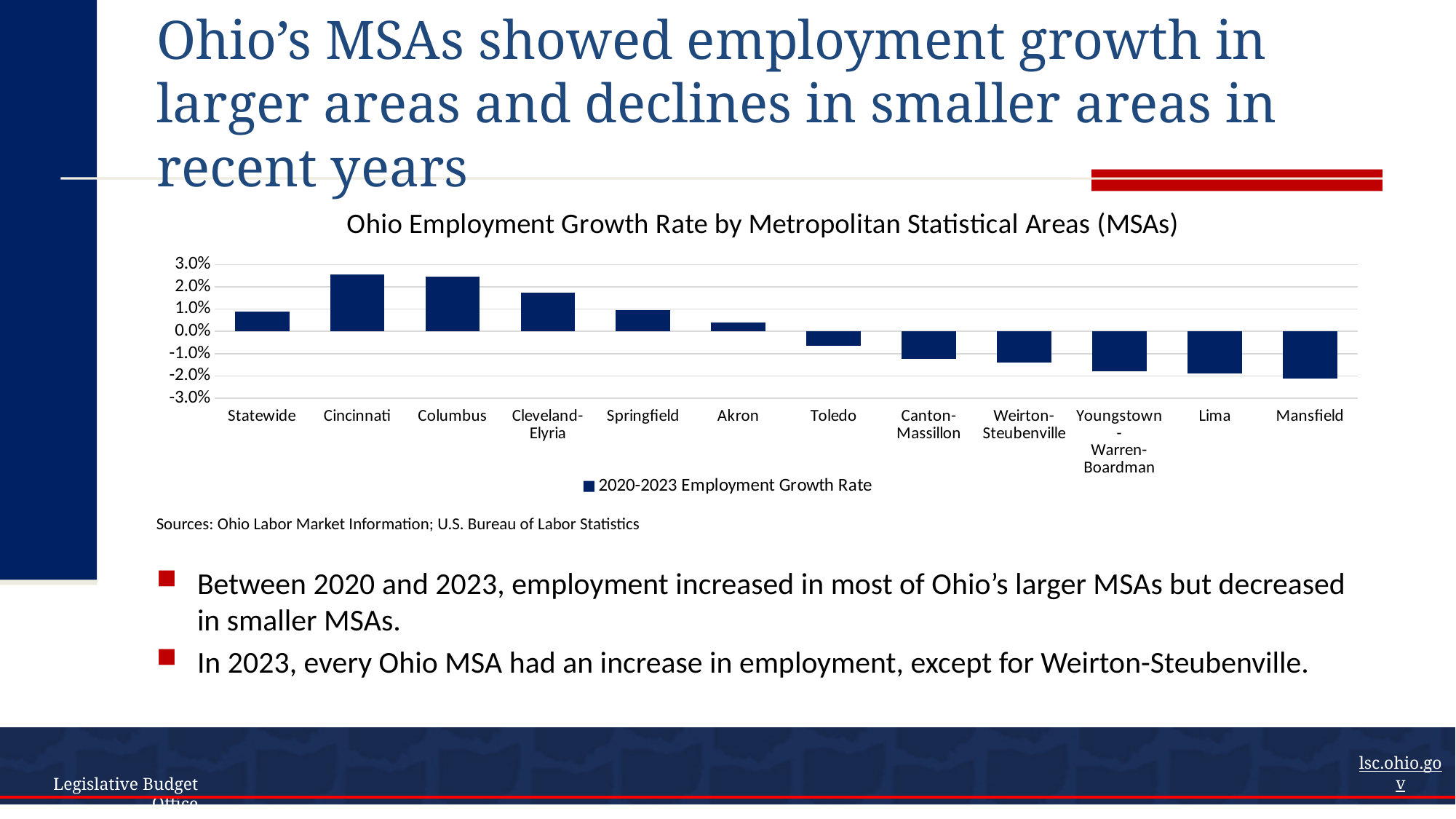
How many series does the chart's legend list? 1 Which category has the lowest employment growth rate in the chart? Mansfield Do the values generally rise or fall moving from left to right along the x axis? fall Which has the larger employment growth rate, Toledo or Mansfield? Toledo Is the value for Cleveland-Elyria greater or less than 1.0%? greater Which has the larger employment growth rate, Cleveland-Elyria or Springfield? Cleveland-Elyria How many categories are shown on the x axis of the chart? 12 What kind of chart is shown on the slide? bar chart What series name is shown in the chart's legend? 2020-2023 Employment Growth Rate Is the value for Mansfield greater or less than -1.0%? less Is the value for Akron greater or less than 1.0%? less